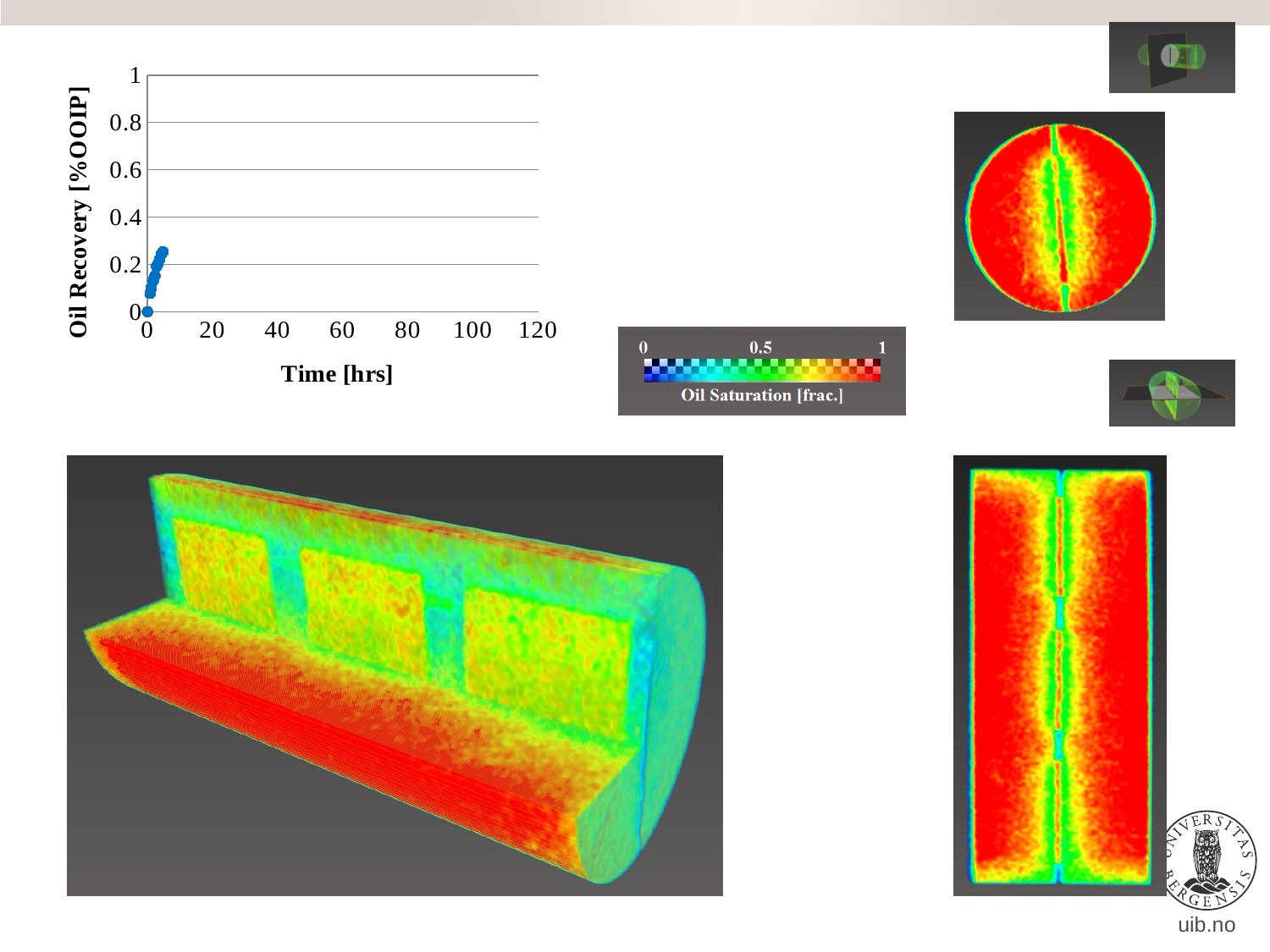
Is the highest plotted oil recovery value greater or less than 0.4? less Do the oil recovery values rise or fall as time increases? rise Is the highest plotted oil recovery value greater or less than 0.6? less What is the title of the y axis of the chart? Oil Recovery [%OOIP] Are all the plotted points at times greater or less than 20 hrs? less What is the title of the x axis of the chart? Time [hrs] What is the maximum value shown on the x axis of the chart? 120 What kind of chart is shown on the slide? scatter chart